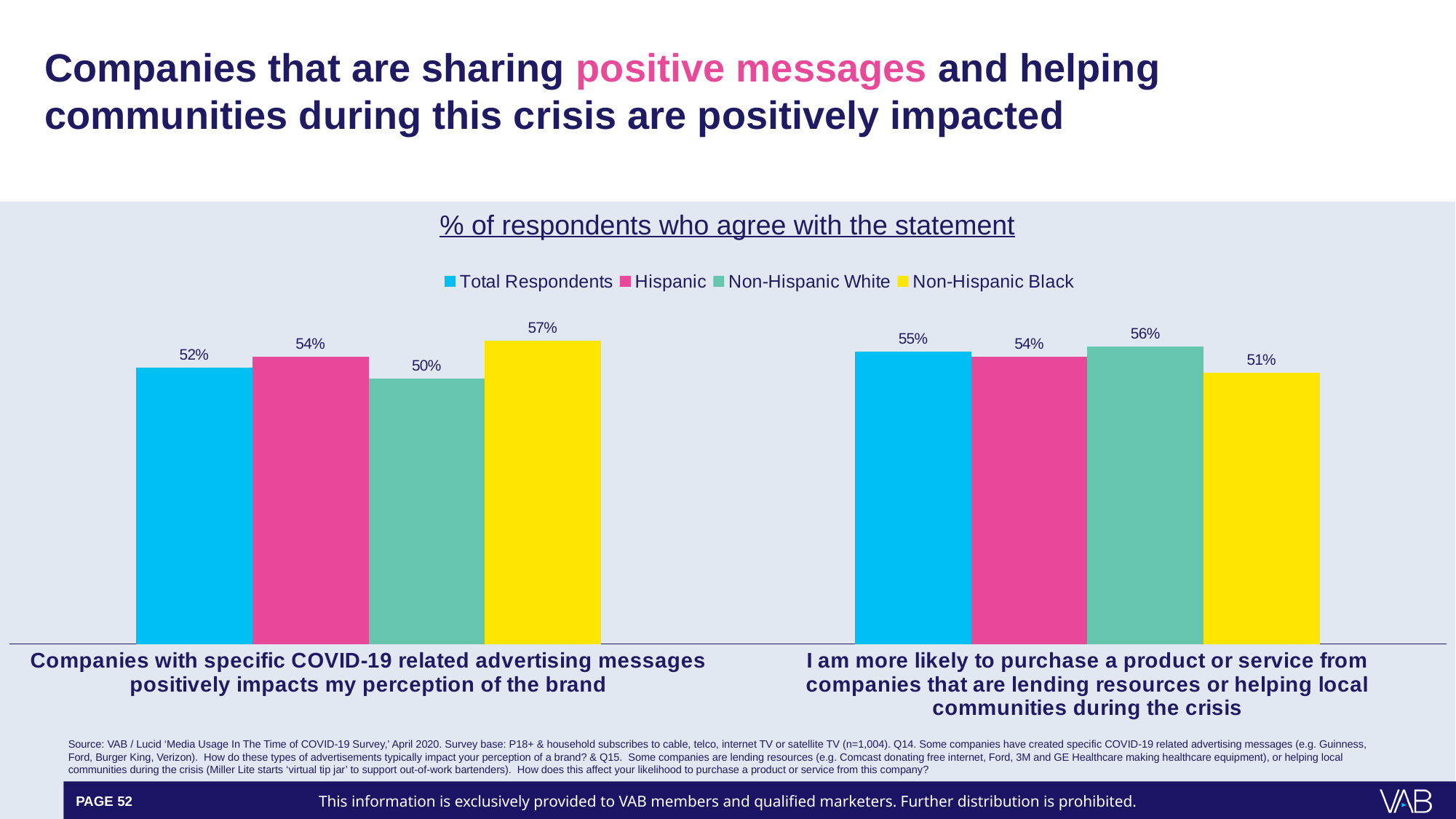
What percentage of Total Respondents agree that companies with specific COVID-19 related advertising messages positively impact their perception of the brand? 52% For Total Respondents, which statement has the higher agreement: the one about COVID-19 related advertising messages or the one about being more likely to purchase from companies helping local communities? Being more likely to purchase from companies helping local communities Which group has the highest share agreeing that COVID-19 related advertising messages positively impact their perception of the brand? Non-Hispanic Black What percentage of Non-Hispanic Black respondents agree that companies with specific COVID-19 related advertising messages positively impact their perception of the brand? 57% How many series does the legend list? 4 What percentage of Non-Hispanic White respondents agree they are more likely to purchase from companies lending resources or helping local communities during the crisis? 56% Which group has the lowest share agreeing that COVID-19 related advertising messages positively impact their perception of the brand? Non-Hispanic White What type of chart is shown on the slide? Bar chart What percentage of Hispanic respondents agree they are more likely to purchase from companies lending resources or helping local communities during the crisis? 54% What is the difference between the Non-Hispanic Black and Non-Hispanic White values for the statement about COVID-19 related advertising messages positively impacting brand perception? 7 percentage points Which group has the lowest share agreeing they are more likely to purchase from companies lending resources or helping local communities? Non-Hispanic Black What is the difference between the Non-Hispanic White and Non-Hispanic Black values for the statement about being more likely to purchase from companies helping local communities? 5 percentage points